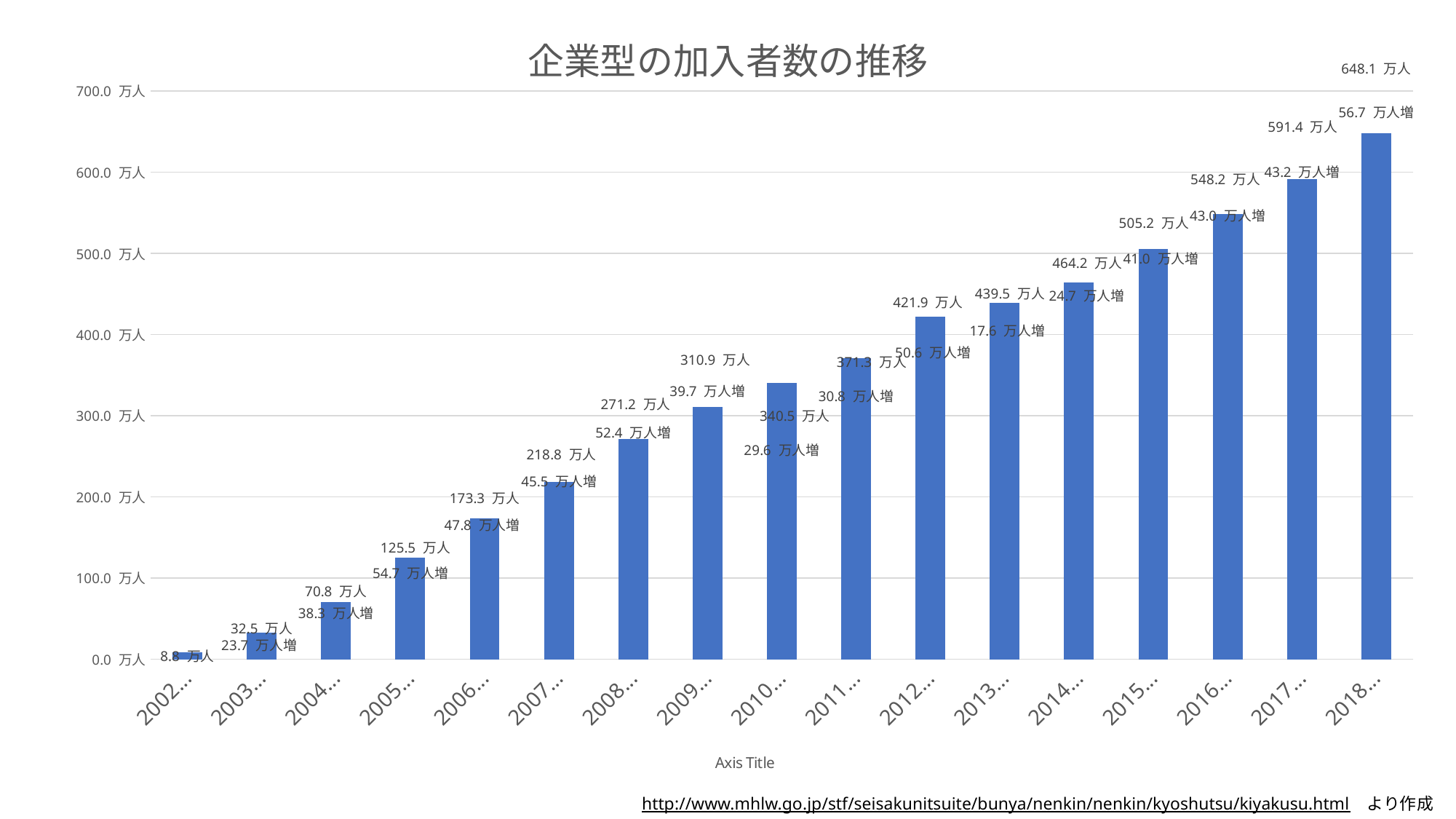
Which is larger, the value for 2009 or the value for 2011? 2011 What is the difference between the values for 2013 and 2012? 17.6 万人 Is the value for 2015 greater or less than 500.0 万人? greater What is the difference between the values for 2018 and 2017? 56.7 万人 What is the value for 2018 in the chart? 648.1 万人 Which year has the lowest value in the chart? 2002 Do the values rise or fall from 2002 to 2018? Rise What kind of chart is shown on the slide? Bar chart How many years (bars) are shown in the chart? 17 What is the value for 2010 in the chart? 340.5 万人 Which year has the highest value in the chart? 2018 What is the value for 2005 in the chart? 125.5 万人